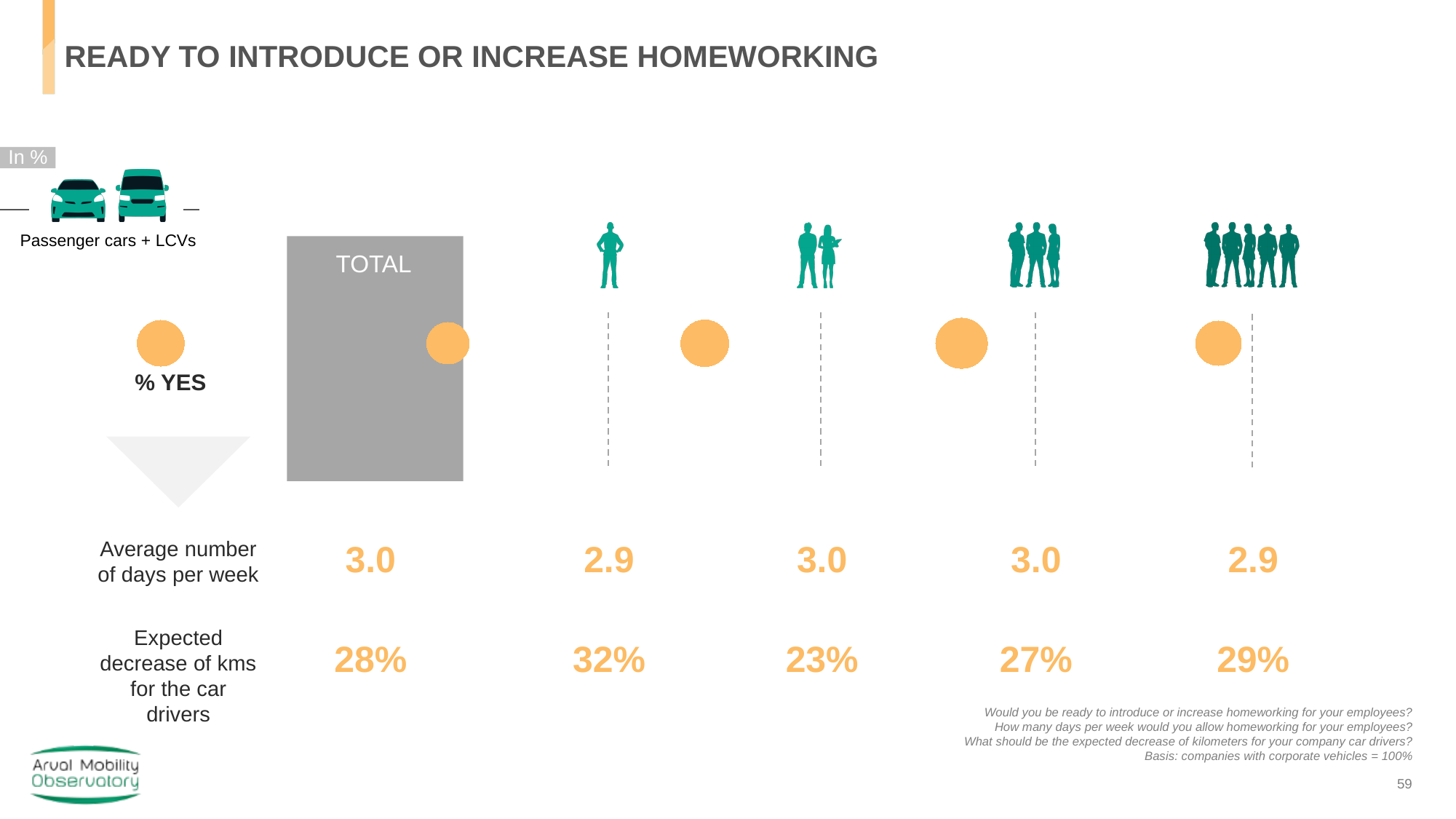
What is the average number of days per week of homeworking shown for the TOTAL column? 3.0 How much higher is the expected decrease of kms in the single-person icon column than in the TOTAL column? 4 percentage points What vehicle segment label is shown under the car icons at the top left of the slide? Passenger cars + LCVs What is the expected decrease of kms for the car drivers in the column with the single-person icon (first column after TOTAL)? 32% What is the expected decrease of kms for the car drivers shown for the TOTAL column? 28% How many columns of values (including TOTAL) are shown in the 'Expected decrease of kms for the car drivers' row? 5 Which column shows the highest expected decrease of kms for the car drivers? The single-person icon column (32%) What is the expected decrease of kms for the car drivers in the column with the two-person icon (second column after TOTAL)? 23% What is the average number of days per week shown in the column with the five-person icon (last column on the right)? 2.9 Which has a larger expected decrease of kms: the three-person icon column or the five-person icon column? The five-person icon column (29%) Which column shows the lowest expected decrease of kms for the car drivers? The two-person icon column (23%) What is the difference between the highest (32%) and lowest (23%) expected decrease of kms values? 9 percentage points